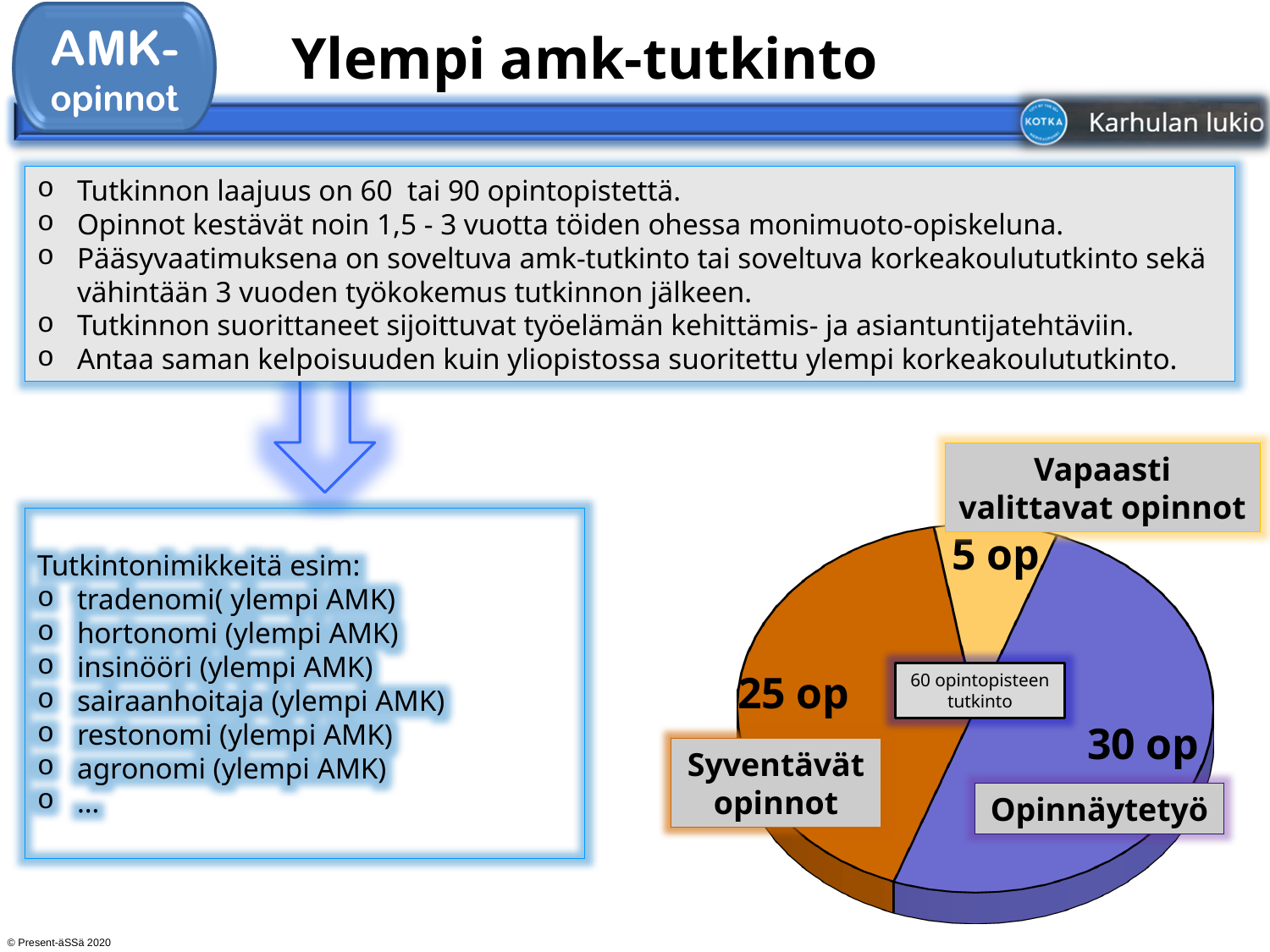
What share of the pie does the Opinnäytetyö slice represent? 50% What is the value of the Vapaasti valittavat opinnot slice? 5 op What is the total of all slices in the pie chart? 60 op Which slice of the pie chart is the smallest? Vapaasti valittavat opinnot What kind of chart is shown on the slide? pie chart What is the value of the Syventävät opinnot slice? 25 op Which is larger, Syventävät opinnot or Vapaasti valittavat opinnot? Syventävät opinnot What is the difference between the Opinnäytetyö and Syventävät opinnot slices? 5 op What is the value of the Opinnäytetyö slice? 30 op What label is shown in the centre of the pie chart? 60 opintopisteen tutkinto Which slice of the pie chart is the largest? Opinnäytetyö How many slices does the pie chart have? 3